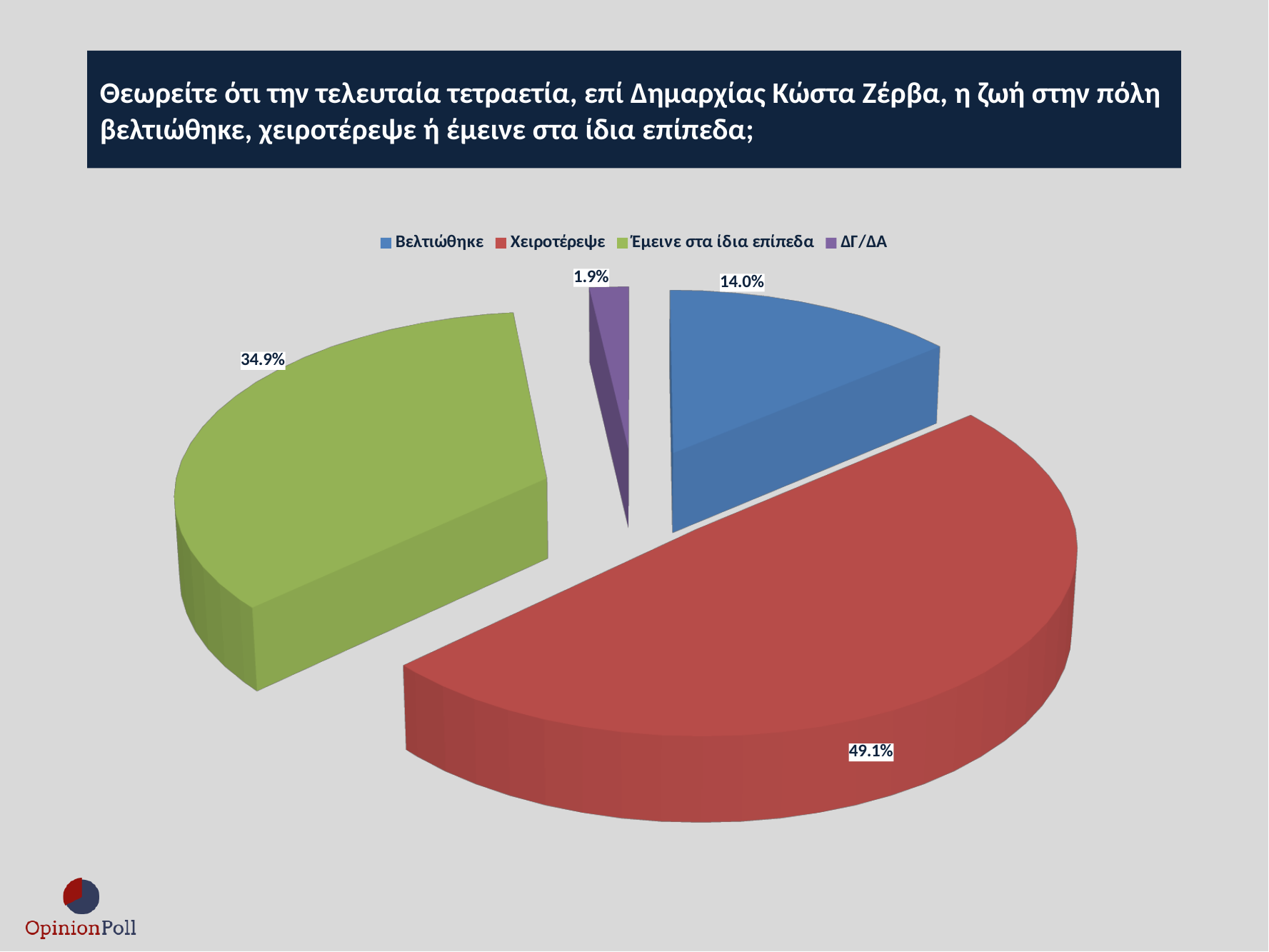
Which is larger, the share for Βελτιώθηκε or the share for Έμεινε στα ίδια επίπεδα? Έμεινε στα ίδια επίπεδα What percentage of respondents answered Έμεινε στα ίδια επίπεδα? 34.9% What percentage of respondents answered ΔΓ/ΔΑ? 1.9% What colour is the slice for Έμεινε στα ίδια επίπεδα? Green What is the difference in percentage points between Χειροτέρεψε and Έμεινε στα ίδια επίπεδα? 14.2 Which response has the largest share of the pie? Χειροτέρεψε Which response has the smallest share of the pie? ΔΓ/ΔΑ What kind of chart is shown on the slide? Pie chart What percentage of respondents answered Βελτιώθηκε? 14.0% What is the combined share of Βελτιώθηκε and Χειροτέρεψε? 63.1% How many slices does the pie chart have? 4 What percentage of respondents answered Χειροτέρεψε? 49.1%